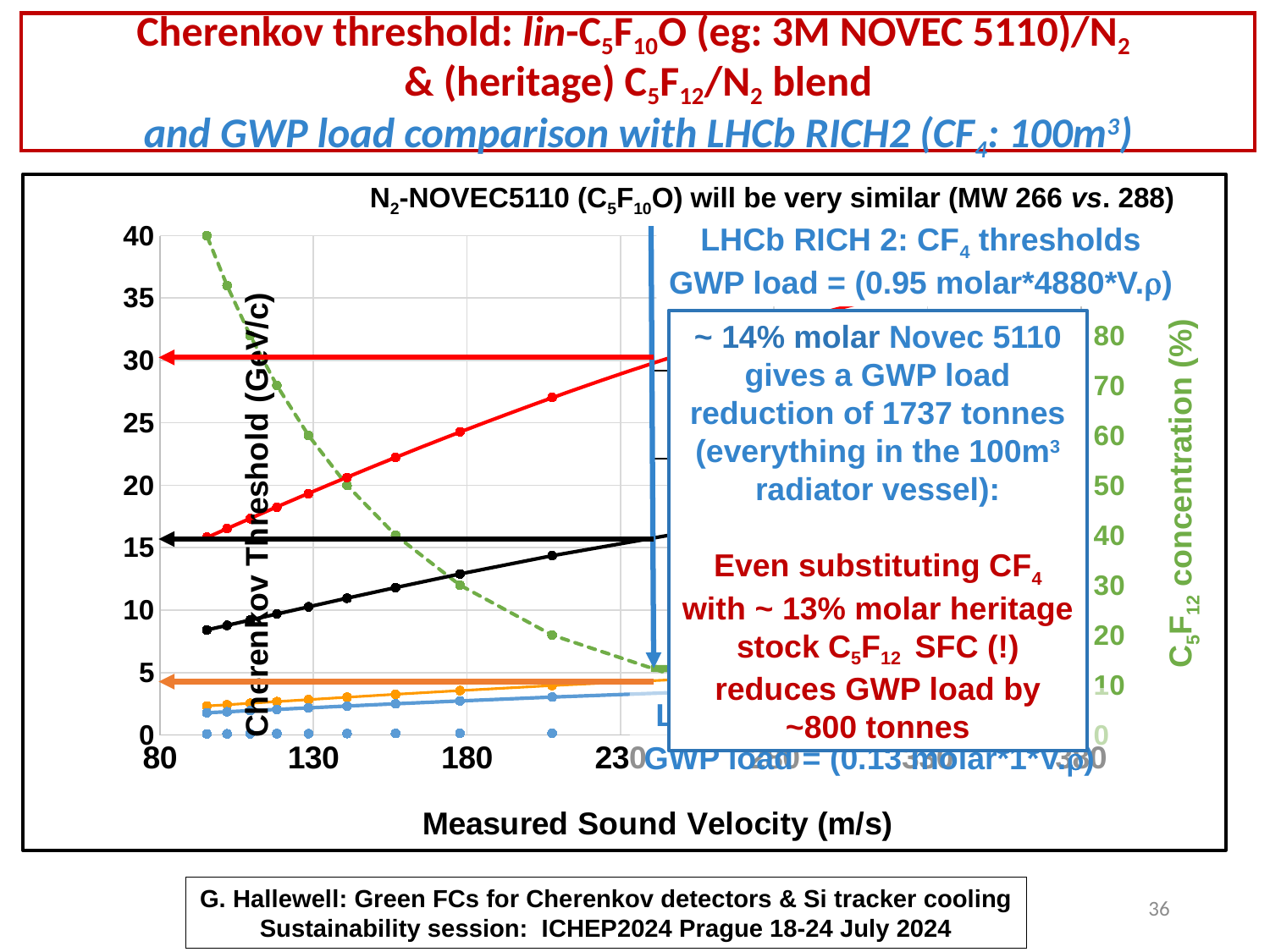
At a sound velocity of 180 m/s, which line shows the higher Cherenkov threshold, the solid red line or the solid black line? the solid red line What kind of chart is shown on the slide? line chart Is the C5F12 concentration shown by the green dashed line at a sound velocity of 130 m/s greater or less than 40%? greater Does the green dashed line rise or fall as the measured sound velocity increases? falls What is the title of the x axis of the chart? Measured Sound Velocity (m/s) Does the solid red line rise or fall as the measured sound velocity increases? rises What is the title of the left y axis of the chart? Cherenkov Threshold (GeV/c) Is the Cherenkov threshold of the solid black line at a sound velocity of 130 m/s greater or less than 5 GeV/c? greater Which solid line reaches the highest Cherenkov threshold on the chart? the red line Is the Cherenkov threshold of the solid black line at a sound velocity of 180 m/s greater or less than 15 GeV/c? less Does the solid black line rise or fall as the measured sound velocity increases? rises